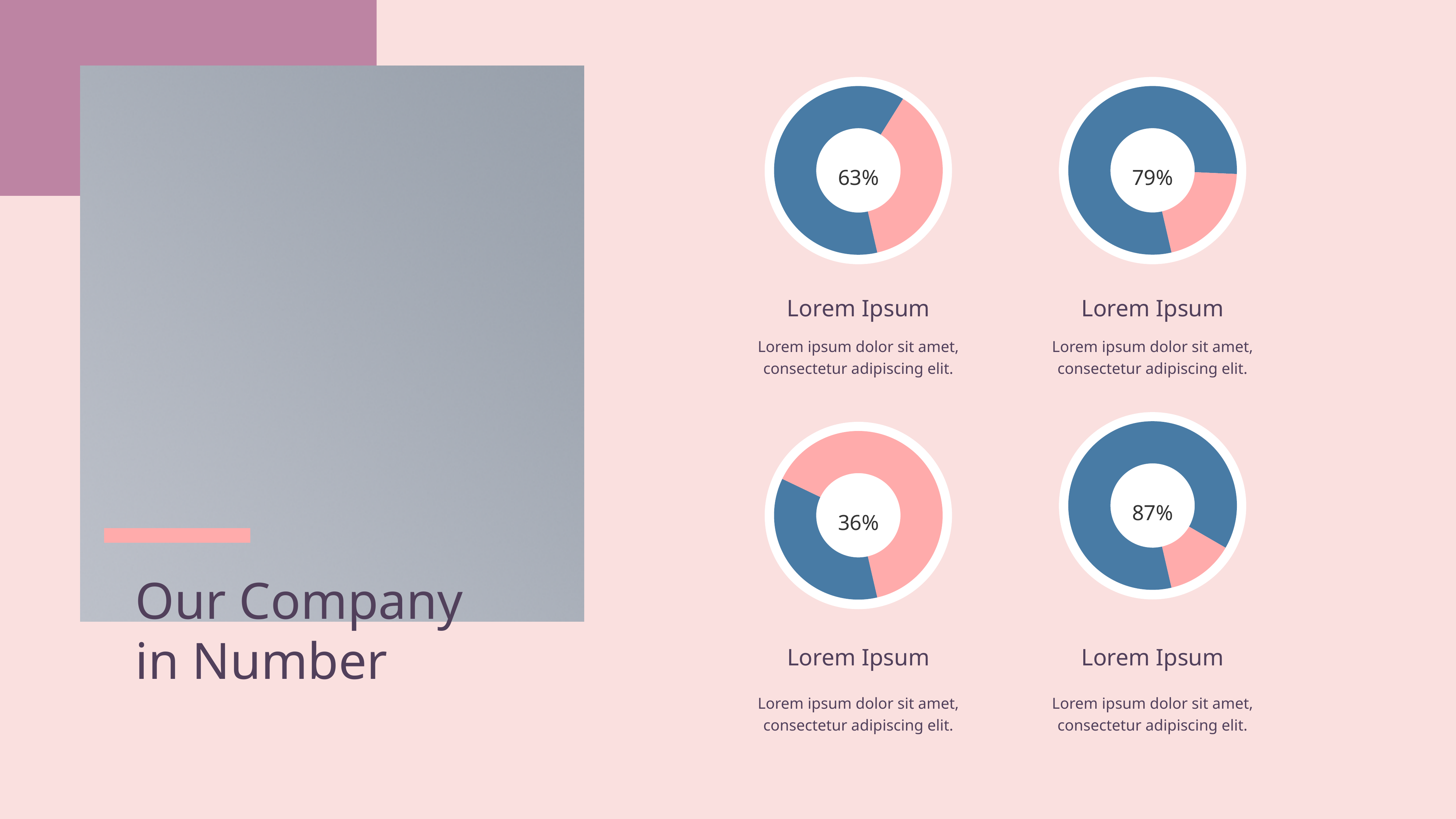
What percentage is shown in the centre of the top-right donut chart? 79% What colour is the filled (percentage) portion of the donut charts? Blue How many donut charts are on the slide? 4 What is the difference between the percentage in the bottom-right donut chart and the percentage in the bottom-left donut chart? 51% Which of the four donut charts shows the highest percentage? The bottom-right chart (87%) What percentage is shown in the centre of the top-left donut chart? 63% Which of the four donut charts shows the lowest percentage? The bottom-left chart (36%) What percentage is shown in the centre of the bottom-right donut chart? 87% What kind of chart is used for each of the four figures on the right of the slide? Donut chart What percentage is shown in the centre of the bottom-left donut chart? 36% What is the difference between the percentage in the top-right donut chart and the percentage in the top-left donut chart? 16% Which shows a larger percentage, the top-left donut chart or the top-right donut chart? The top-right chart